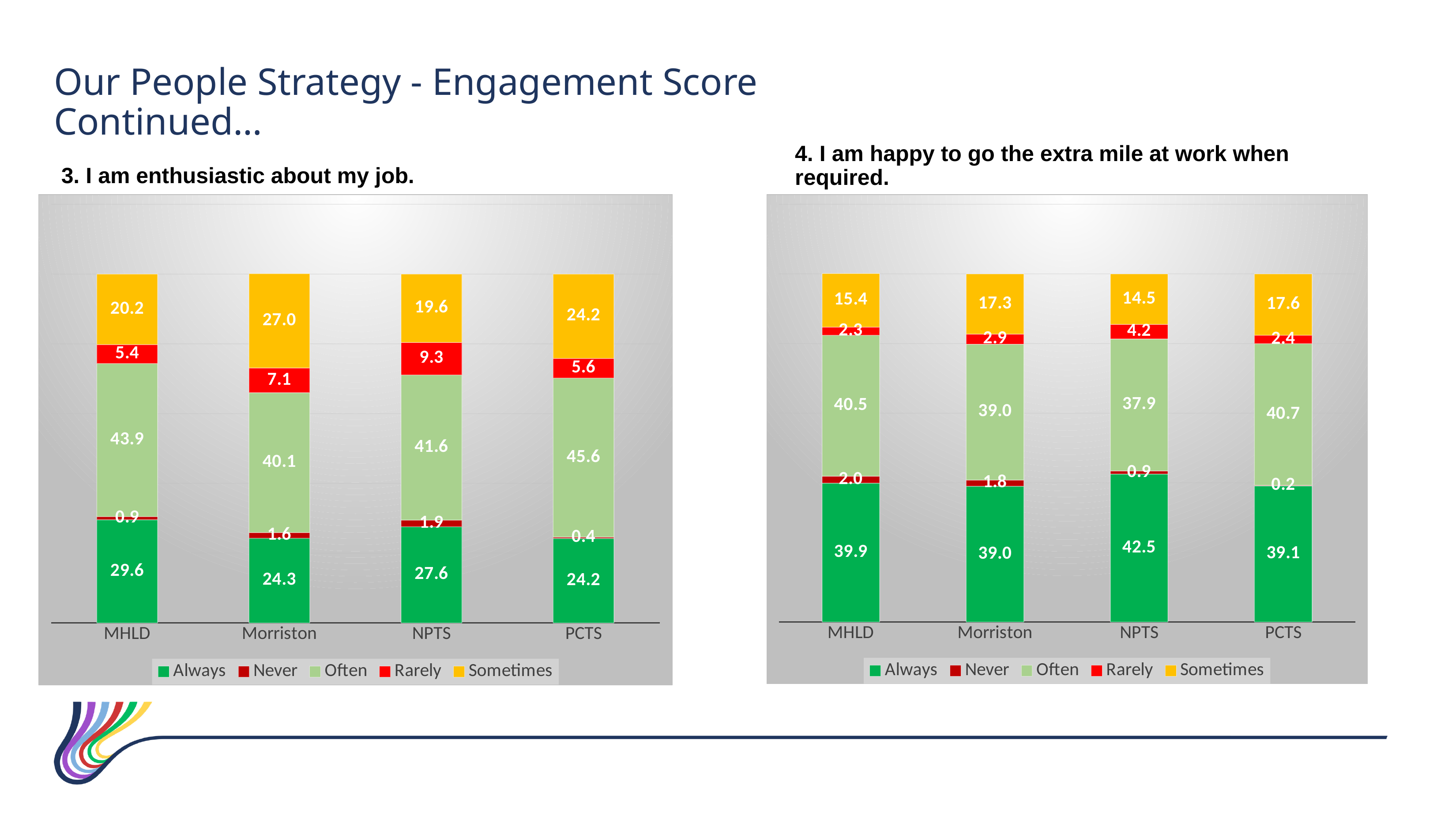
In the chart for "4. I am happy to go the extra mile at work when required.", is the Often value larger for MHLD or NPTS? MHLD What kind of chart is used for "4. I am happy to go the extra mile at work when required."? Stacked bar chart In the chart for "4. I am happy to go the extra mile at work when required.", what is the difference between the Always values for NPTS and Morriston? 3.5 How many series does the legend list in the chart for "3. I am enthusiastic about my job."? 5 In the chart for "3. I am enthusiastic about my job.", what is the difference between the Often values for PCTS and Morriston? 5.5 In the chart for "3. I am enthusiastic about my job.", what is the Sometimes value for Morriston? 27.0 In the chart for "4. I am happy to go the extra mile at work when required.", what is the Rarely value for Morriston? 2.9 In the chart for "4. I am happy to go the extra mile at work when required.", which category has the highest Sometimes value? PCTS In the chart for "3. I am enthusiastic about my job.", which category has the highest Rarely value? NPTS In the chart for "4. I am happy to go the extra mile at work when required.", what is the Always value for NPTS? 42.5 In the chart for "3. I am enthusiastic about my job.", what is the Always value for MHLD? 29.6 In the chart for "3. I am enthusiastic about my job.", which category has the lowest Never value? PCTS